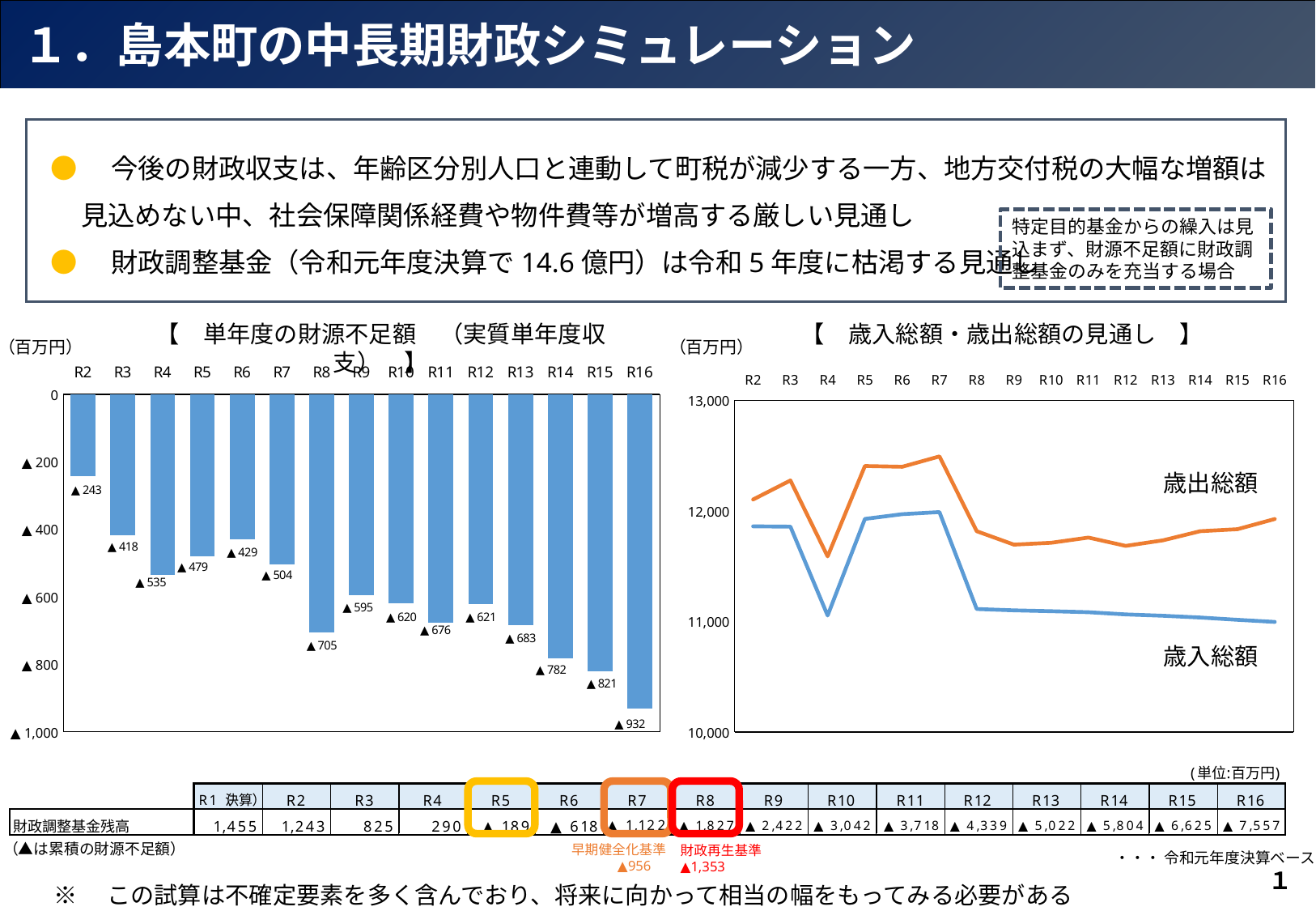
What type of chart is the right chart (歳入総額・歳出総額の見通し)? Line chart In the left chart (単年度の財源不足額), what is the value for R2? ▲243 What type of chart is the left chart (単年度の財源不足額)? Bar chart How many years (bars) are shown in the left chart (単年度の財源不足額)? 15 In the left chart (単年度の財源不足額), which year has the largest shortfall (longest bar)? R16 In the left chart (単年度の財源不足額), what is the value for R8? ▲705 In the left chart (単年度の財源不足額), what is the difference between the R16 value (932) and the R15 value (821)? 111 In the left chart (単年度の財源不足額), which bar is longer, R4 or R5? R4 In the left chart (単年度の財源不足額), what is the value for R16? ▲932 In the right chart (歳入総額・歳出総額の見通し), which line is higher at R16, 歳出総額 or 歳入総額? 歳出総額 In the left chart (単年度の財源不足額), which year has the smallest shortfall (shortest bar)? R2